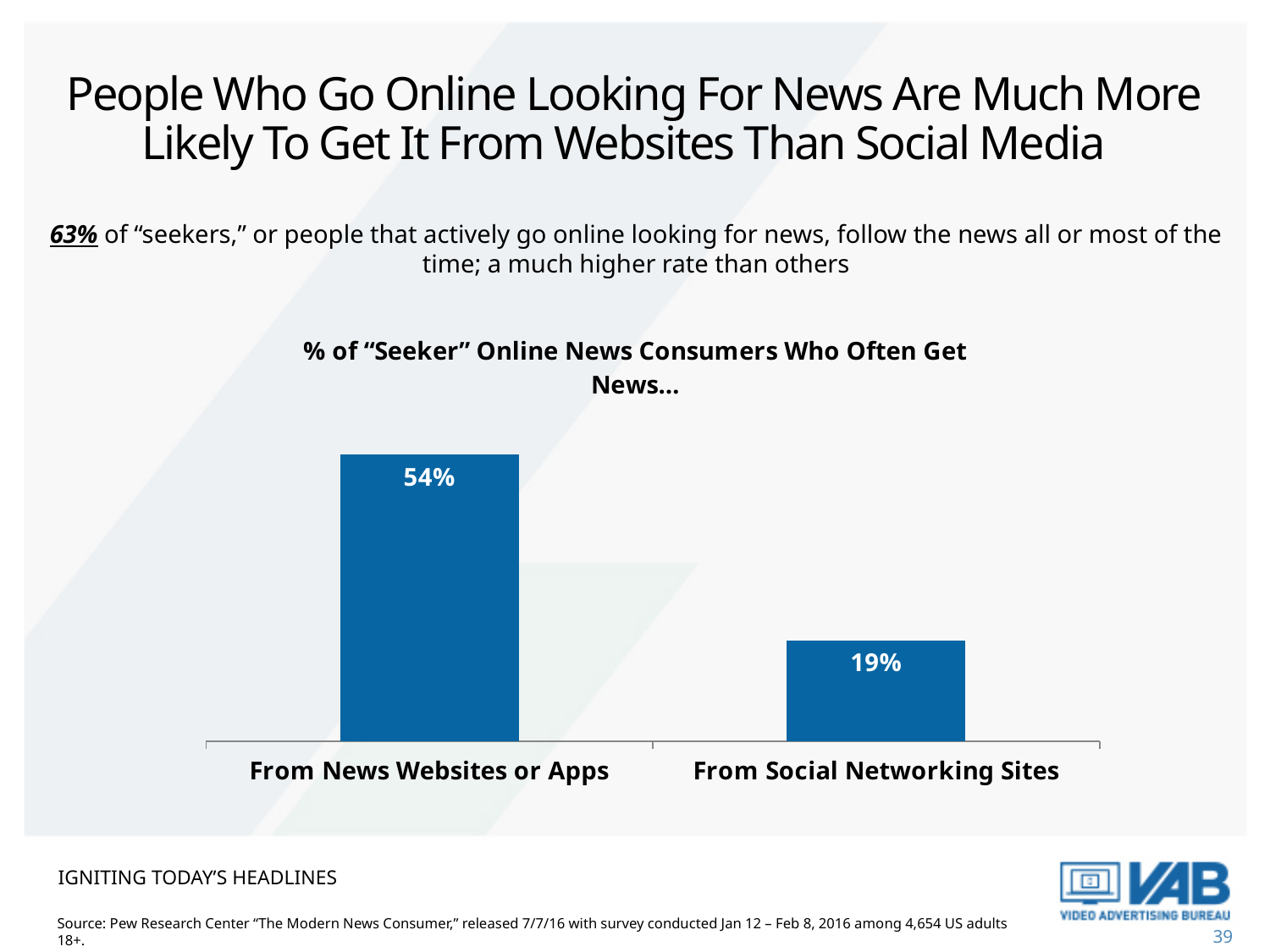
What is the title of the chart? % of "Seeker" Online News Consumers Who Often Get News... What percentage of "seeker" online news consumers often get news from social networking sites? 19% What percentage of "seeker" online news consumers often get news from news websites or apps? 54% What colour are the bars in the chart? Blue Which category has the highest value in the chart? From News Websites or Apps How many categories are shown in the chart? 2 Which is larger: the value for news websites or apps, or the value for social networking sites? From News Websites or Apps Which category has the lowest value in the chart? From Social Networking Sites What is the difference in percentage points between the value for news websites or apps and the value for social networking sites? 35 What kind of chart is shown on the slide? Bar chart Do the values rise or fall from left to right across the chart? Fall